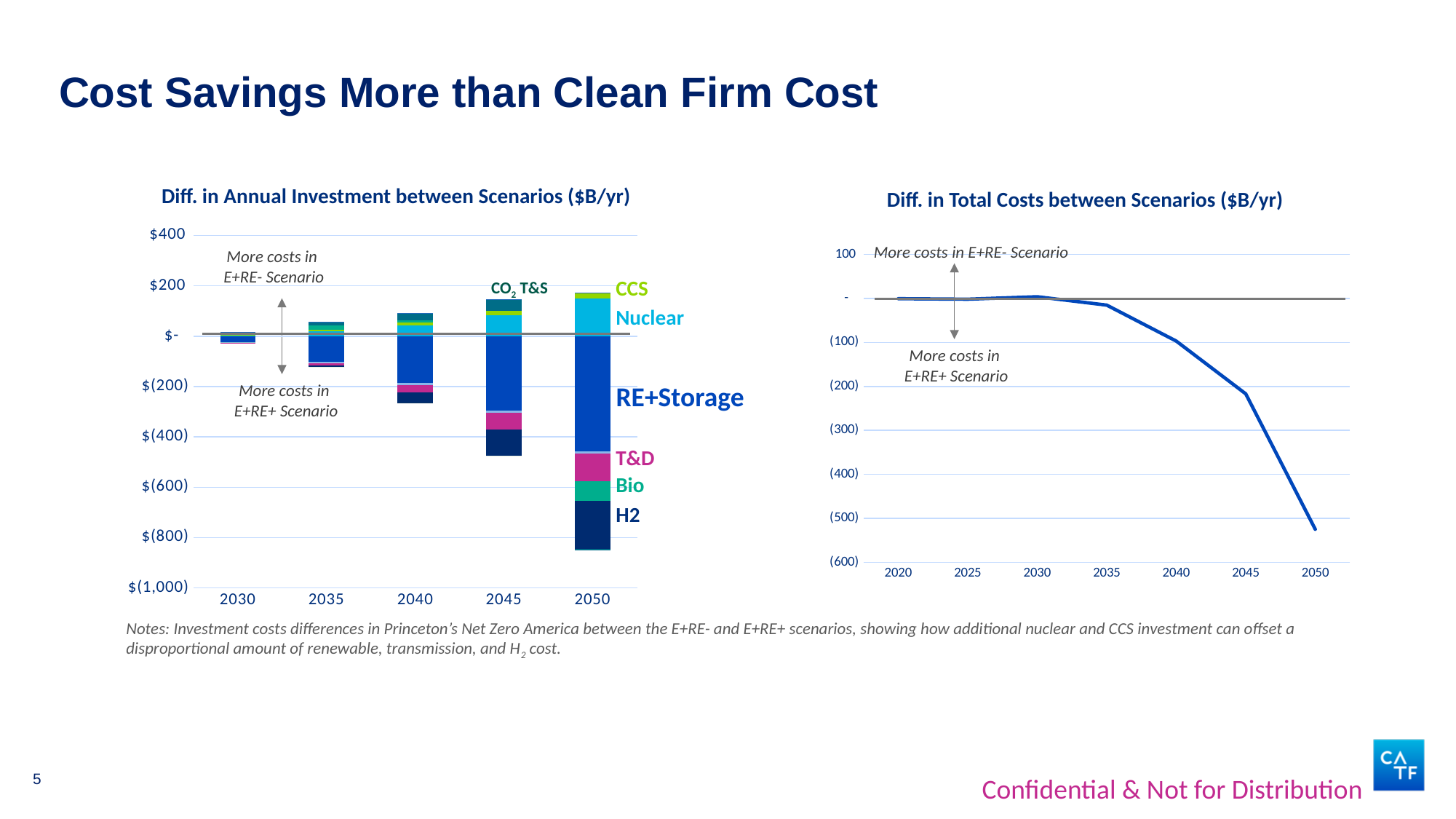
In the left chart, which series is labelled in dark blue at the bottom of the 2050 bar? H2 In the right chart, 'Diff. in Total Costs between Scenarios', is the value for 2045 greater or less than (300)? greater What kind of chart is the left chart, 'Diff. in Annual Investment between Scenarios ($B/yr)'? Stacked bar chart What kind of chart is the right chart, 'Diff. in Total Costs between Scenarios ($B/yr)'? Line chart In the left chart, 'Diff. in Annual Investment between Scenarios', how many years are shown on the x axis? 5 In the left chart, what does the annotation above the zero line say? More costs in E+RE- Scenario In the left chart, 'Diff. in Annual Investment between Scenarios', is the top of the 2050 stacked bar greater or less than $200? less In the left chart, 'Diff. in Annual Investment between Scenarios', does the bottom of the 2050 stacked bar extend below $(800)? Yes In the right chart, 'Diff. in Total Costs between Scenarios', how many years are shown on the x axis? 7 How many series (cost categories) are labelled in the left chart, 'Diff. in Annual Investment between Scenarios'? 7 In the right chart, 'Diff. in Total Costs between Scenarios', does the line rise or fall from 2030 to 2050? Fall